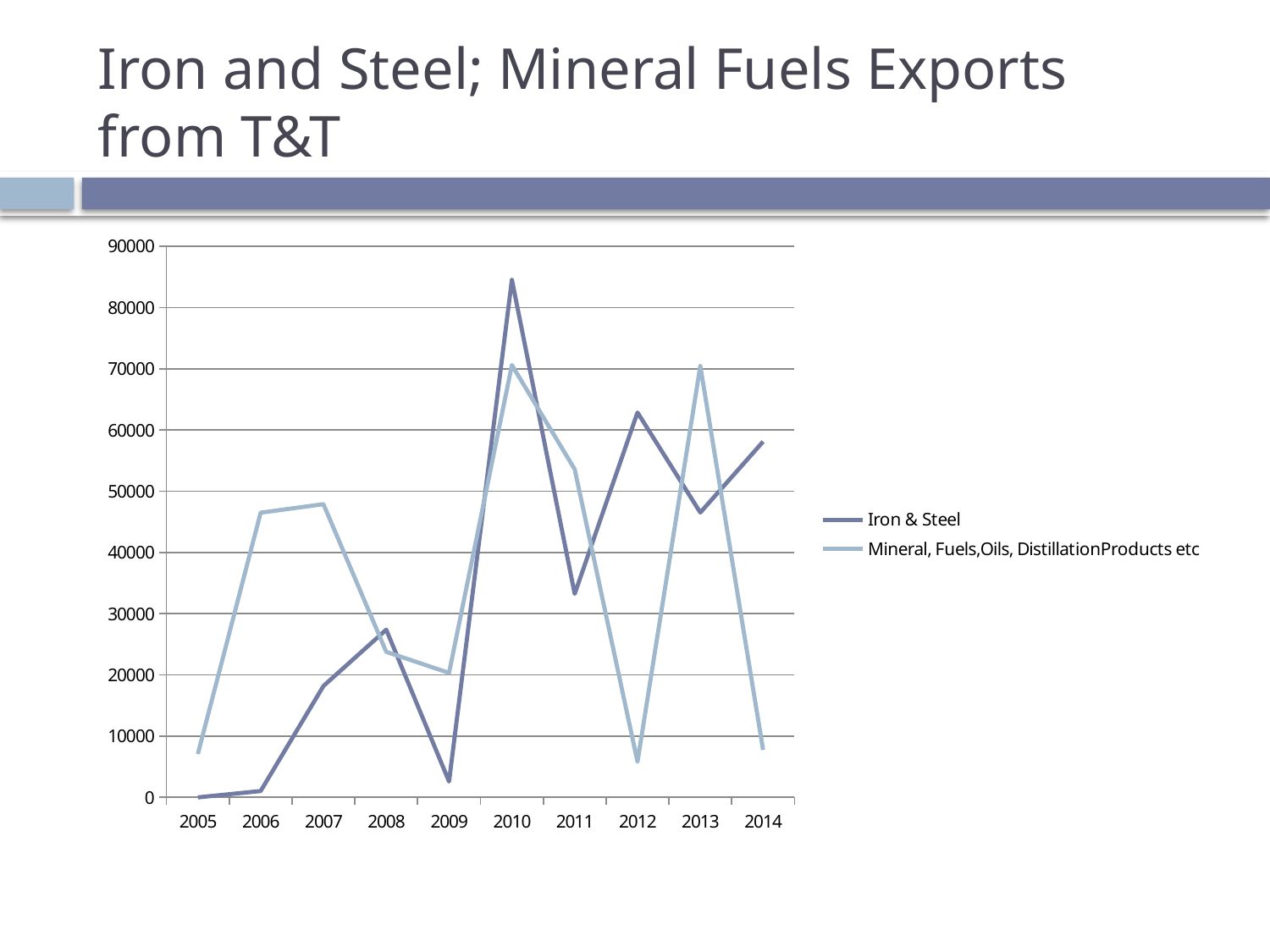
In 2012, which series has the larger value, Iron & Steel or Mineral, Fuels,Oils, DistillationProducts etc? Iron & Steel Does the Iron & Steel line rise or fall from 2005 to 2008? rise Is the Iron & Steel value for 2010 greater or less than 80000? greater Is the Iron & Steel value for 2009 greater or less than 10000? less What is the title of the slide containing the chart? Iron and Steel; Mineral Fuels Exports from T&T How many series does the legend list? 2 In 2007, which series has the larger value, Iron & Steel or Mineral, Fuels,Oils, DistillationProducts etc? Mineral, Fuels,Oils, DistillationProducts etc In which year is the Iron & Steel value highest? 2010 How many years are plotted along the x axis? 10 What kind of chart is shown on the slide? line chart Is the Mineral, Fuels,Oils, DistillationProducts etc value for 2012 greater or less than 10000? less In which year is the Iron & Steel value lowest? 2005